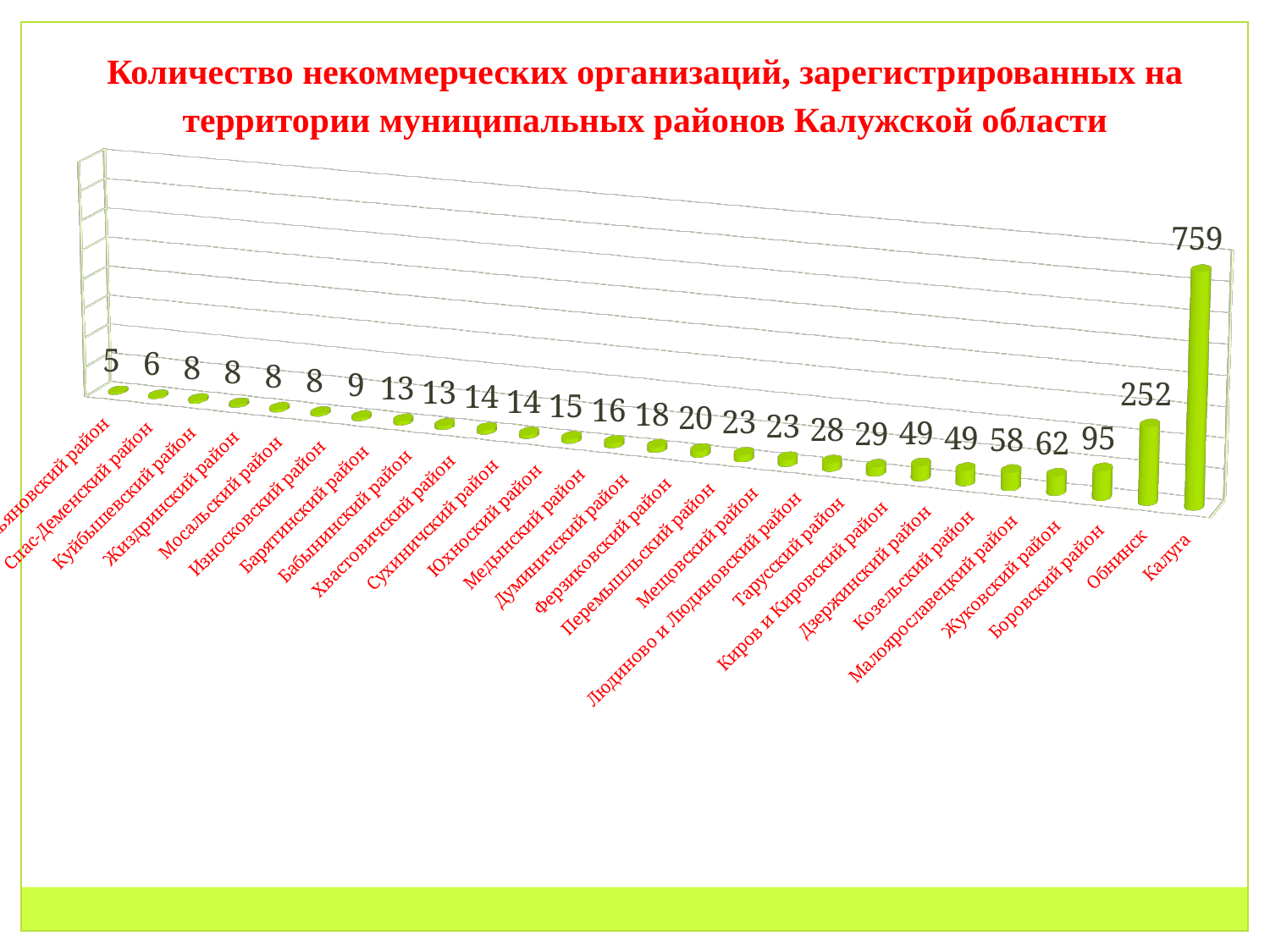
Do the values rise or fall from left to right along the x axis? Rise How many categories are shown on the chart? 26 What is the value for Боровский район? 95 What is the value for Обнинск? 252 What is the value for Тарусский район? 28 Which category has the highest value? Калуга Which is larger, the value for Малоярославецкий район or the value for Жуковский район? Жуковский район What is the value for Жуковский район? 62 What kind of chart is shown on the slide? Bar chart What is the difference between the values for Калуга and Обнинск? 507 Which category has the lowest value? Ульяновский район What is the value for Калуга? 759